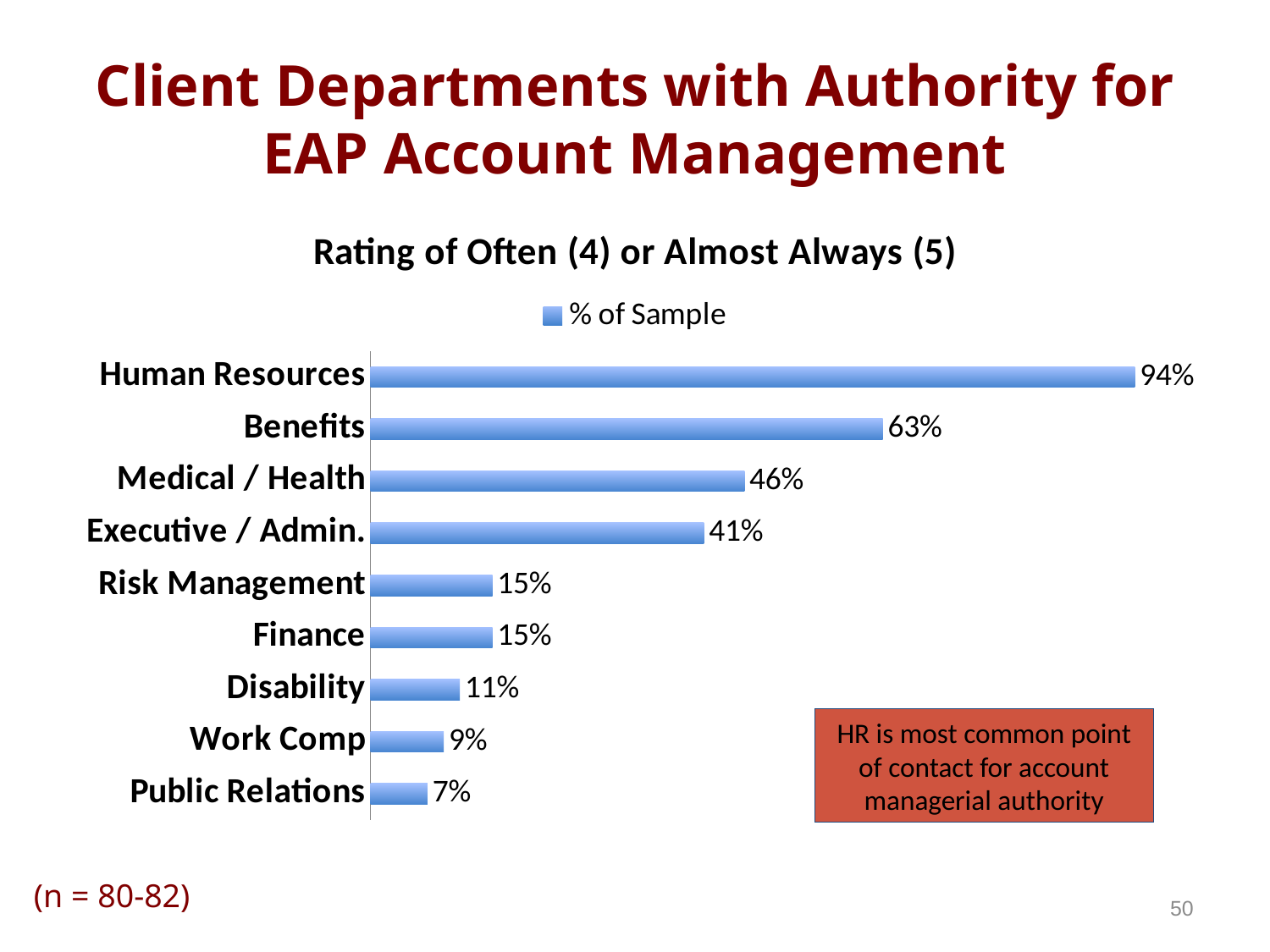
Which category has the highest value? Human Resources How many categories are shown in the chart? 9 What is the value for Work Comp? 9% What series name does the legend show? % of Sample What is the value for Human Resources? 94% Which is larger, the value for Medical / Health or the value for Executive / Admin.? Medical / Health What kind of chart is shown on the slide? Bar chart What is the value for Benefits? 63% What is the difference between the values for Human Resources and Benefits? 31% Which category has the lowest value? Public Relations What is the value for Executive / Admin.? 41% What is the difference between the values for Medical / Health and Disability? 35%